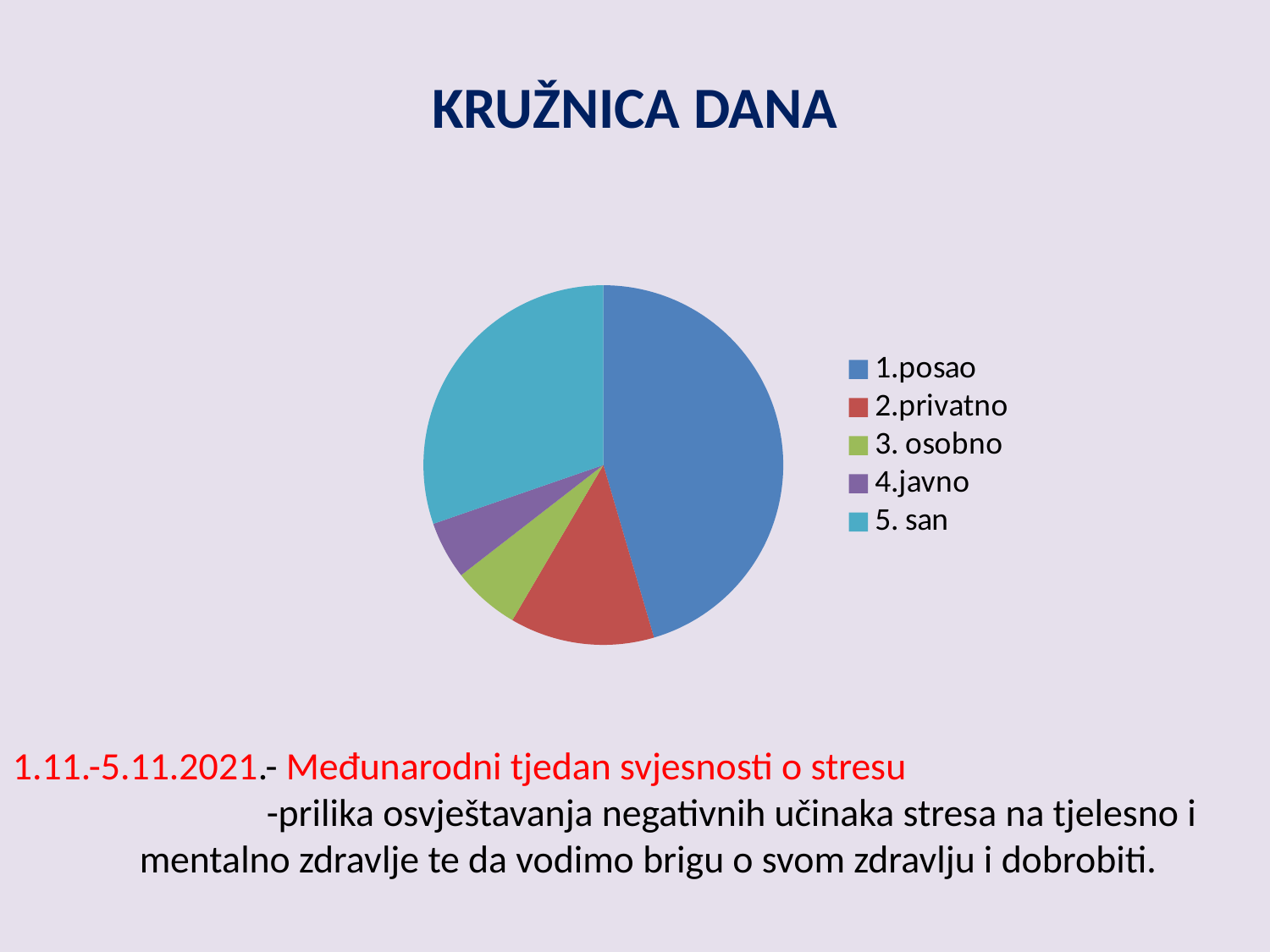
Which slice is larger, 5. san or 4.javno? 5. san What is the title shown above the pie chart? KRUŽNICA DANA Which category has the largest slice in the pie chart? 1.posao What kind of chart is shown on the slide? pie chart What colour is the slice for 2.privatno in the pie chart? red Which slice is larger, 5. san or 2.privatno? 5. san How many entries does the legend of the pie chart list? 5 Which category is the second largest slice in the pie chart? 5. san How many categories (slices) does the pie chart have? 5 Which slice is larger, 1.posao or 5. san? 1.posao